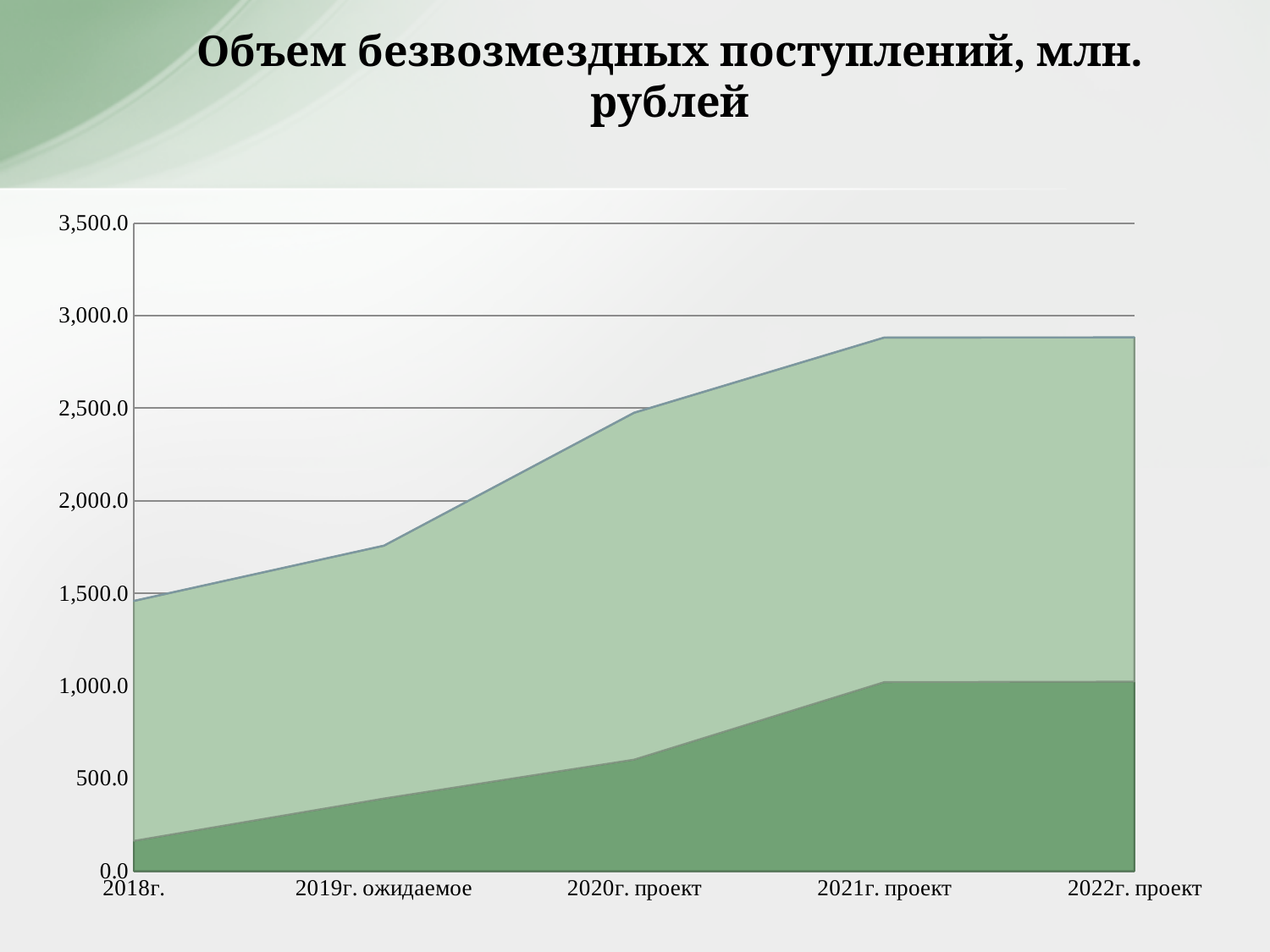
Is the value of the lower (dark green) series for 2018г. greater or less than 500? less How many categories are shown on the x axis? 5 Which has the larger total value, 2019г. ожидаемое or 2020г. проект? 2020г. проект What is the title of the chart? Объем безвозмездных поступлений, млн. рублей Does the total value rise or fall from 2018г. to 2021г. проект? rise Which category has the lowest total value? 2018г. Is the value of the lower (dark green) series for 2021г. проект greater or less than 500? greater Is the total value for 2020г. проект greater or less than 2,000? greater What kind of chart is shown on the slide? area chart